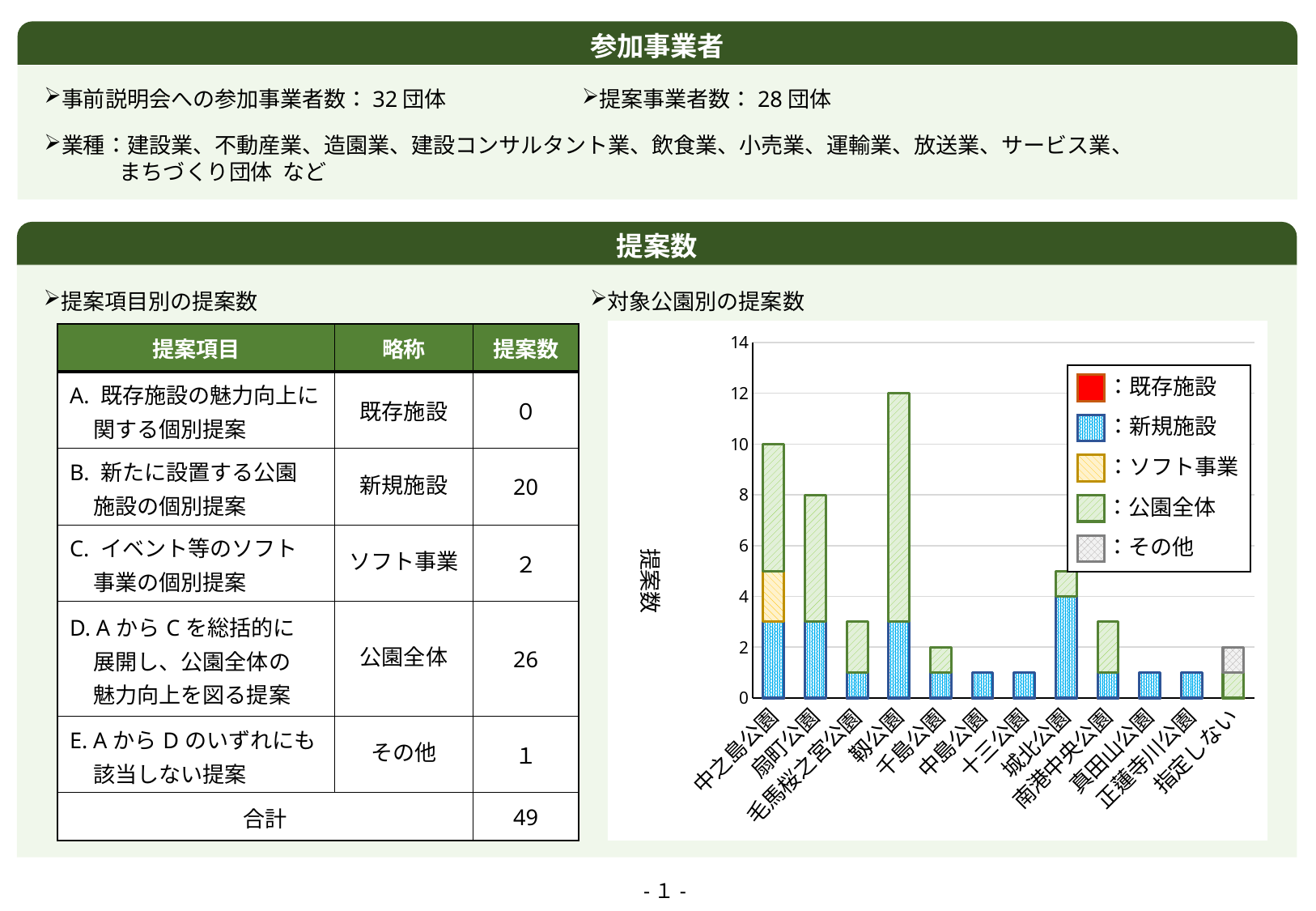
In the 対象公園別の提案数 chart, how many parks (categories) are shown on the x axis? 12 In the 対象公園別の提案数 chart, which has a larger total: 中之島公園 or 扇町公園? 中之島公園 In the 対象公園別の提案数 chart, what is the total number of proposals for 靭公園? 12 In the 対象公園別の提案数 chart, is the total for 城北公園 greater or less than 4? greater What kind of chart is shown under 対象公園別の提案数? bar chart In the 対象公園別の提案数 chart, is the total for 毛馬桜之宮公園 greater or less than 4? less In the 対象公園別の提案数 chart, what is the total number of proposals for 中之島公園? 10 How many series does the legend of the 対象公園別の提案数 chart list? 5 In the 対象公園別の提案数 chart, what is the difference between the totals for 靭公園 and 扇町公園? 4 In the 対象公園別の提案数 chart, which park has the highest total number of proposals? 靱公園 What is the label on the vertical axis of the 対象公園別の提案数 chart? 提案数 In the 対象公園別の提案数 chart, what is the total number of proposals for 扇町公園? 8